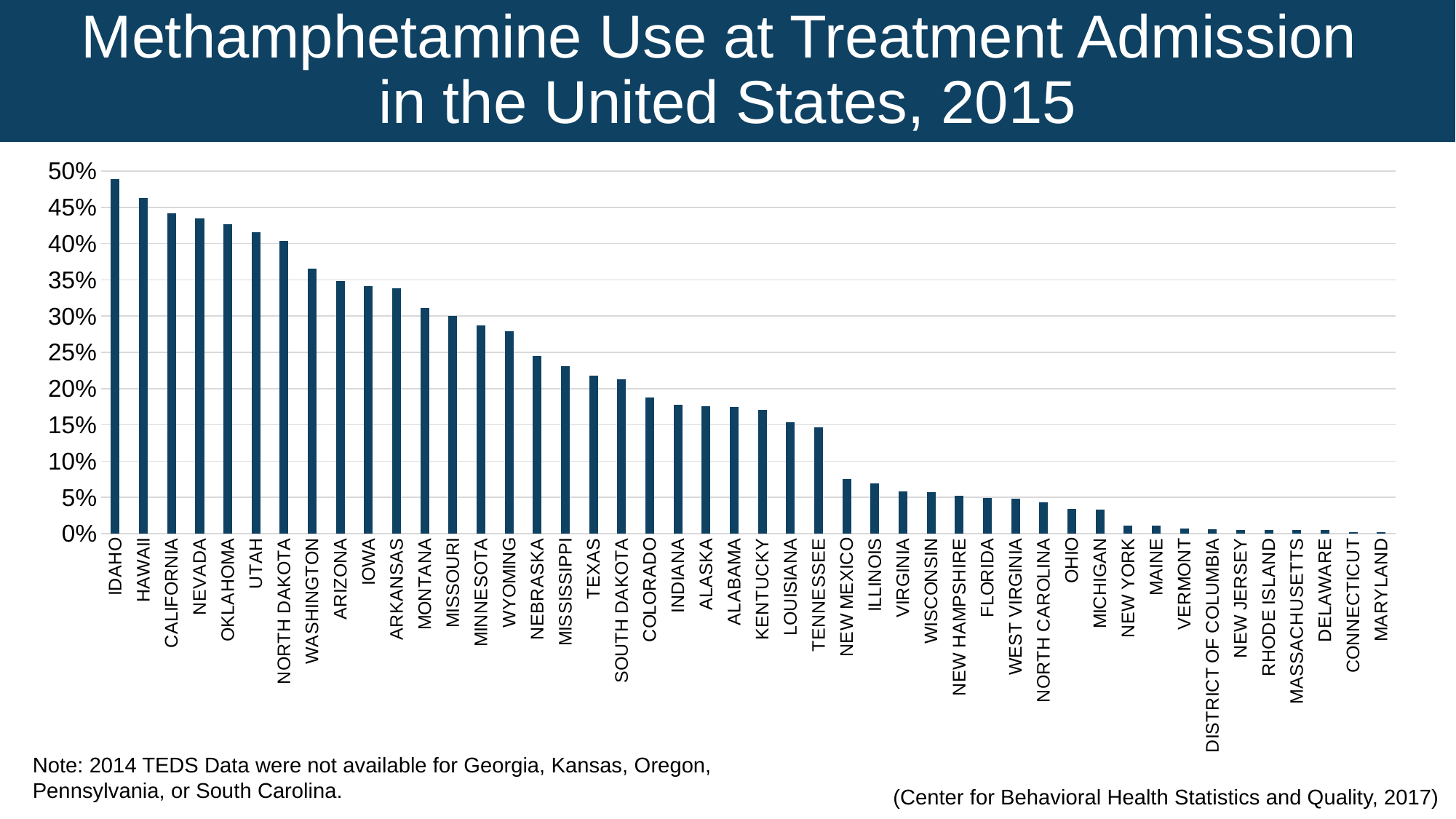
Is the value for Idaho greater or less than 45%? greater Which state has the lowest methamphetamine use at treatment admission? Maryland What kind of chart is shown on the slide? bar chart Do the values rise or fall moving from left to right along the x axis? fall What is the title of the chart? Methamphetamine Use at Treatment Admission in the United States, 2015 Is the value for Washington greater or less than 35%? greater Is the value for Colorado greater or less than 20%? less Which state has the highest methamphetamine use at treatment admission? Idaho Which has a higher value, Hawaii or Nevada? Hawaii How many states or jurisdictions are shown on the x axis? 46